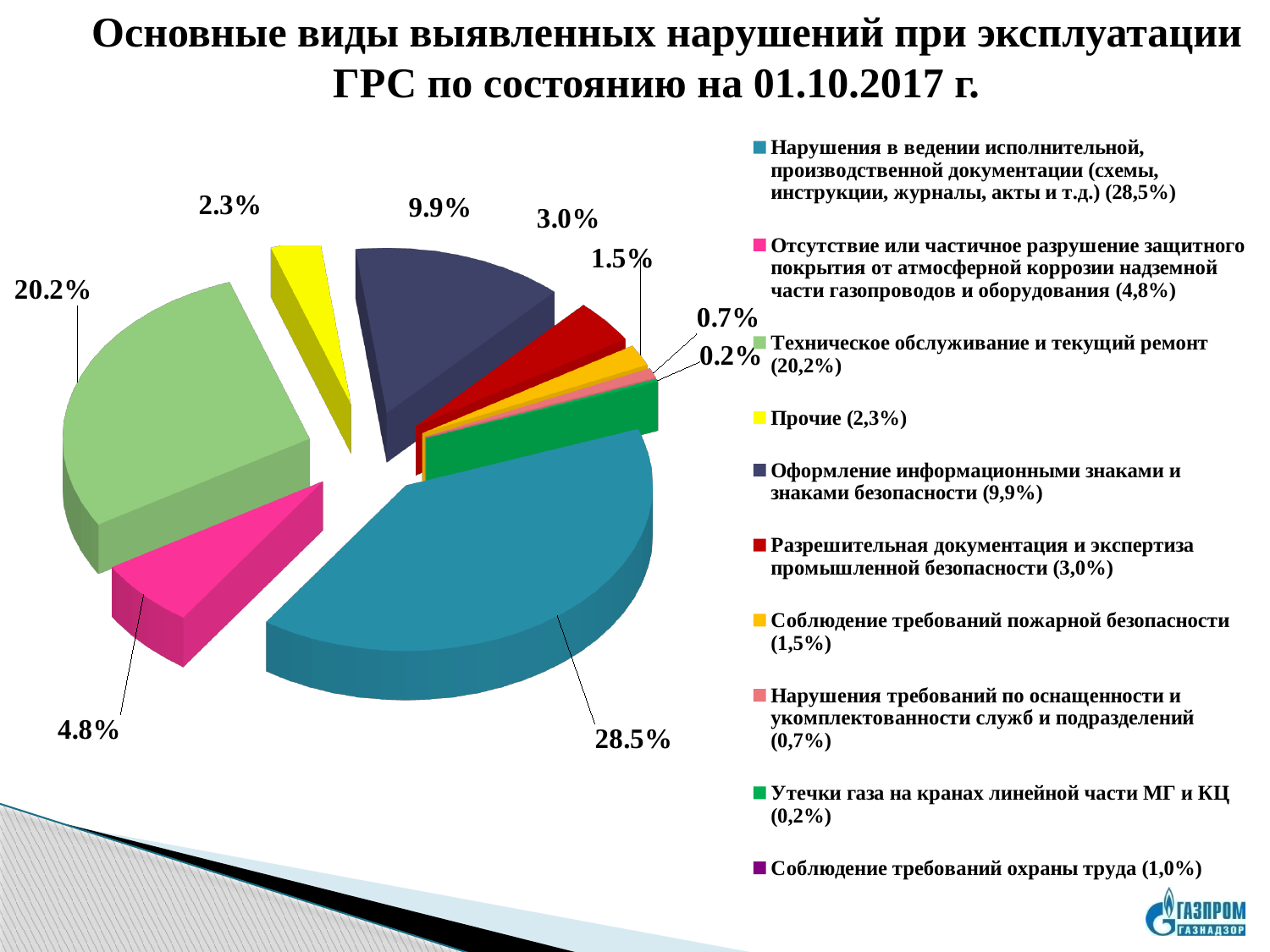
What is the title of the chart? Основные виды выявленных нарушений при эксплуатации ГРС по состоянию на 01.10.2017 г. What kind of chart is shown on the slide? pie chart What is the value for "Оформление информационными знаками и знаками безопасности"? 9.9% How many categories does the legend list? 10 Which category has the largest share of the pie? Нарушения в ведении исполнительной, производственной документации (схемы, инструкции, журналы, акты и т.д.) Which is larger: the share for "Отсутствие или частичное разрушение защитного покрытия" or for "Разрешительная документация и экспертиза промышленной безопасности"? Отсутствие или частичное разрушение защитного покрытия What is the value for "Прочие"? 2.3% Which category has the smallest share of the pie? Утечки газа на кранах линейной части МГ и КЦ What is the difference in percentage points between the largest slice (28.5%) and "Техническое обслуживание и текущий ремонт" (20.2%)? 8.3 What is the value for "Соблюдение требований пожарной безопасности"? 1.5% What share of the pie does "Техническое обслуживание и текущий ремонт" have? 20.2% What is the difference in percentage points between "Оформление информационными знаками и знаками безопасности" and "Отсутствие или частичное разрушение защитного покрытия"? 5.1